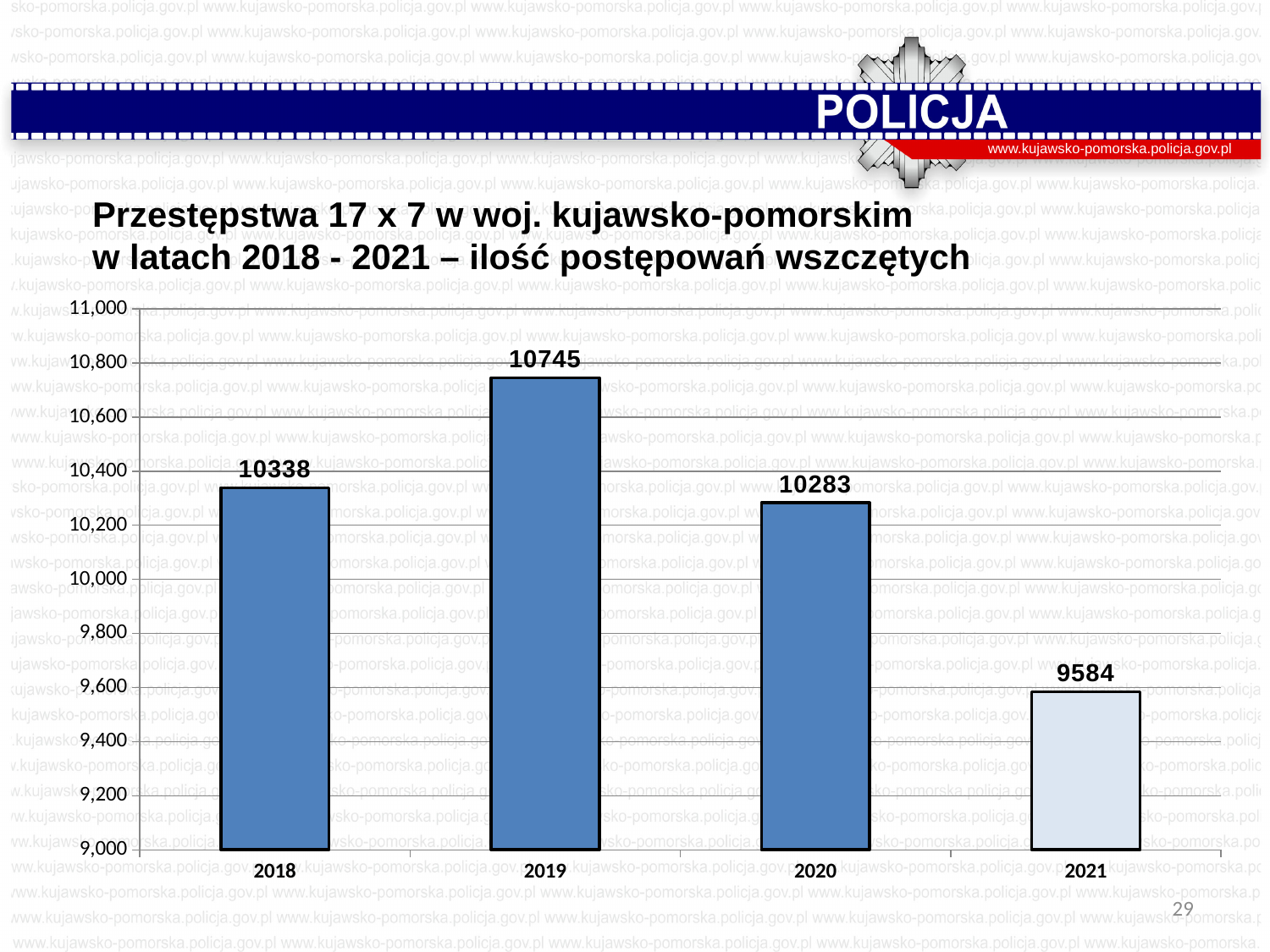
What is the value for 2021? 9584 Which year has the lowest value? 2021 What is the difference between the values for 2019 and 2020? 462 Which is larger, the value for 2018 or the value for 2020? 2018 Is the value for 2021 greater or less than 10,000? less How many years are shown on the chart? 4 What is the value for 2019? 10745 What is the value for 2018? 10338 Do the values rise or fall from 2019 to 2021? fall What kind of chart is shown on the slide? bar chart Which year has the highest value? 2019 What is the difference between the values for 2018 and 2021? 754